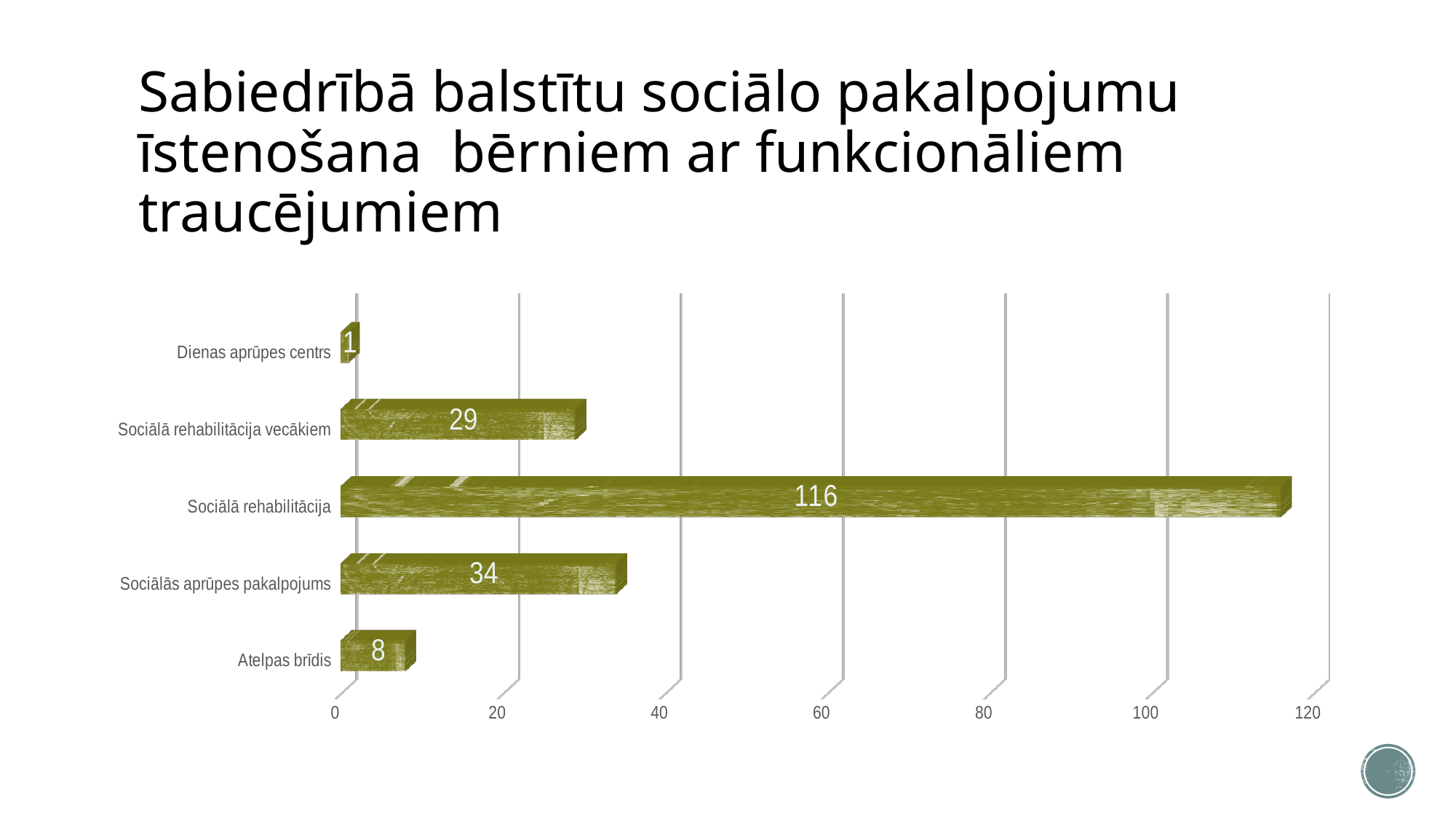
What kind of chart is shown on the slide? bar chart What is the difference between the values for Sociālā rehabilitācija vecākiem and Atelpas brīdis? 21 Is the value for Sociālā rehabilitācija greater or less than 100? greater Which category has the lowest value? Dienas aprūpes centrs Which is larger, the value for Sociālās aprūpes pakalpojums or the value for Sociālā rehabilitācija vecākiem? Sociālās aprūpes pakalpojums What is the value for Atelpas brīdis? 8 What is the value for Sociālā rehabilitācija? 116 What is the value for Sociālā rehabilitācija vecākiem? 29 How many categories are shown in the chart? 5 Which category has the highest value? Sociālā rehabilitācija What is the difference between the values for Sociālā rehabilitācija and Sociālās aprūpes pakalpojums? 82 What is the value for Sociālās aprūpes pakalpojums? 34